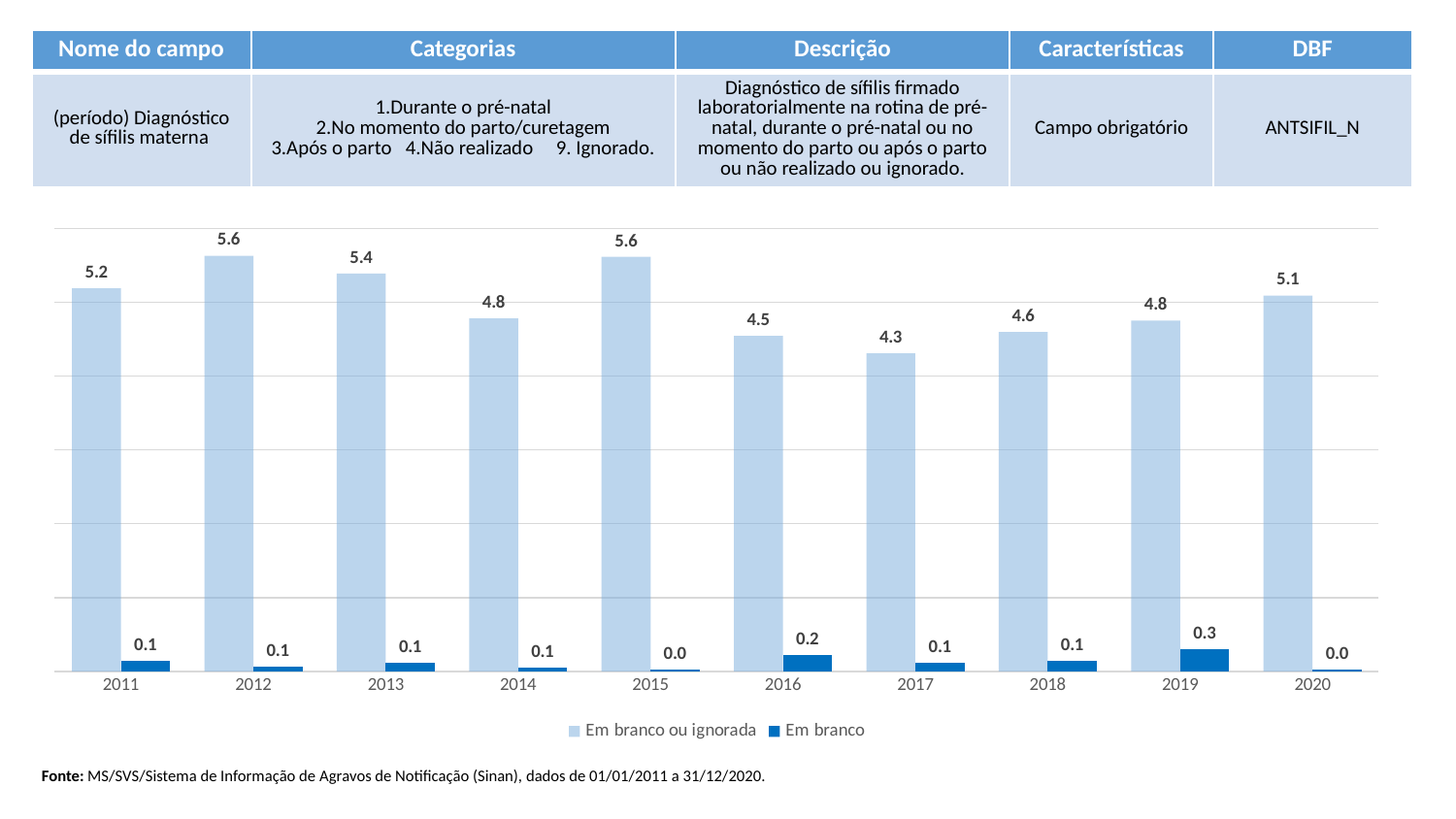
Which year has the lowest value for "Em branco ou ignorada"? 2017 Which is larger, the "Em branco ou ignorada" value for 2013 or for 2014? 2013 What are the two series named in the chart legend? Em branco ou ignorada; Em branco What is the value for "Em branco ou ignorada" in 2011? 5.2 How many series does the chart legend list? 2 How many years are shown on the x axis of the chart? 10 What is the value for "Em branco ou ignorada" in 2017? 4.3 What is the value for "Em branco" in 2016? 0.2 What kind of chart is shown on the slide? Bar chart What is the value for "Em branco" in 2019? 0.3 What is the difference between the "Em branco ou ignorada" values for 2012 and 2017? 1.3 Which year has the highest value for "Em branco"? 2019